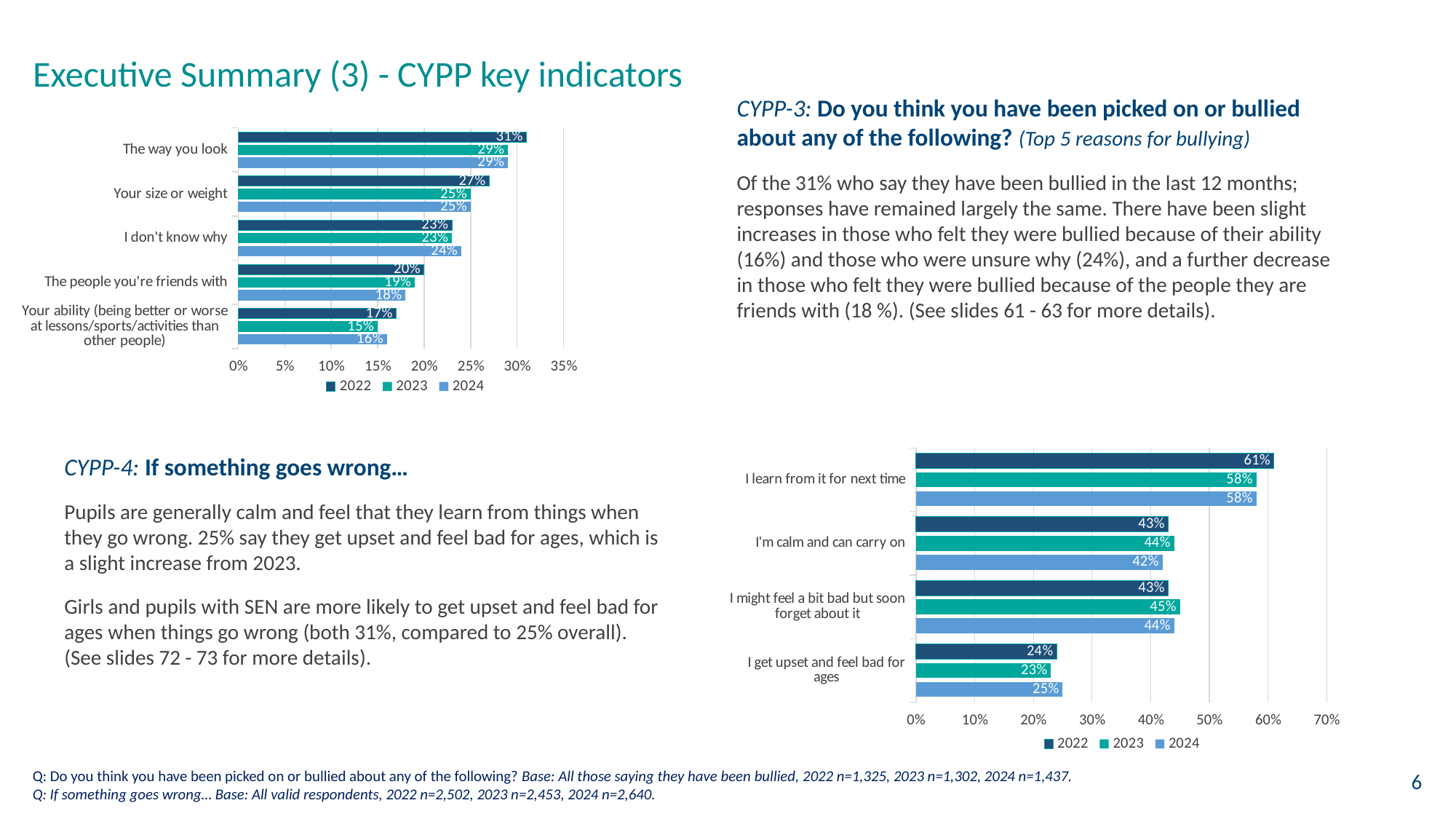
In the top-left chart, how many series does the legend list? 3 In the top-left chart, what is the difference between the 2022 and 2024 values for 'The people you're friends with'? 2% What type of chart is the bottom-right chart? Bar chart In the top-left chart, which category has the lowest 2023 value? Your ability (being better or worse at lessons/sports/activities than other people) In the bottom-right chart, what is the difference between the 2022 and 2023 values for 'I learn from it for next time'? 3% In the top-left chart, how many categories are shown? 5 In the top-left chart, which category has the highest 2022 value? The way you look In the top-left chart, what is the 2024 value for 'The way you look'? 29% In the bottom-right chart, which is larger: the 2023 value for 'I'm calm and can carry on' or the 2023 value for 'I might feel a bit bad but soon forget about it'? I might feel a bit bad but soon forget about it In the bottom-right chart, what is the 2022 value for 'I learn from it for next time'? 61% In the top-left chart, what is the 2022 value for 'Your size or weight'? 27% In the bottom-right chart, what is the 2024 value for 'I get upset and feel bad for ages'? 25%